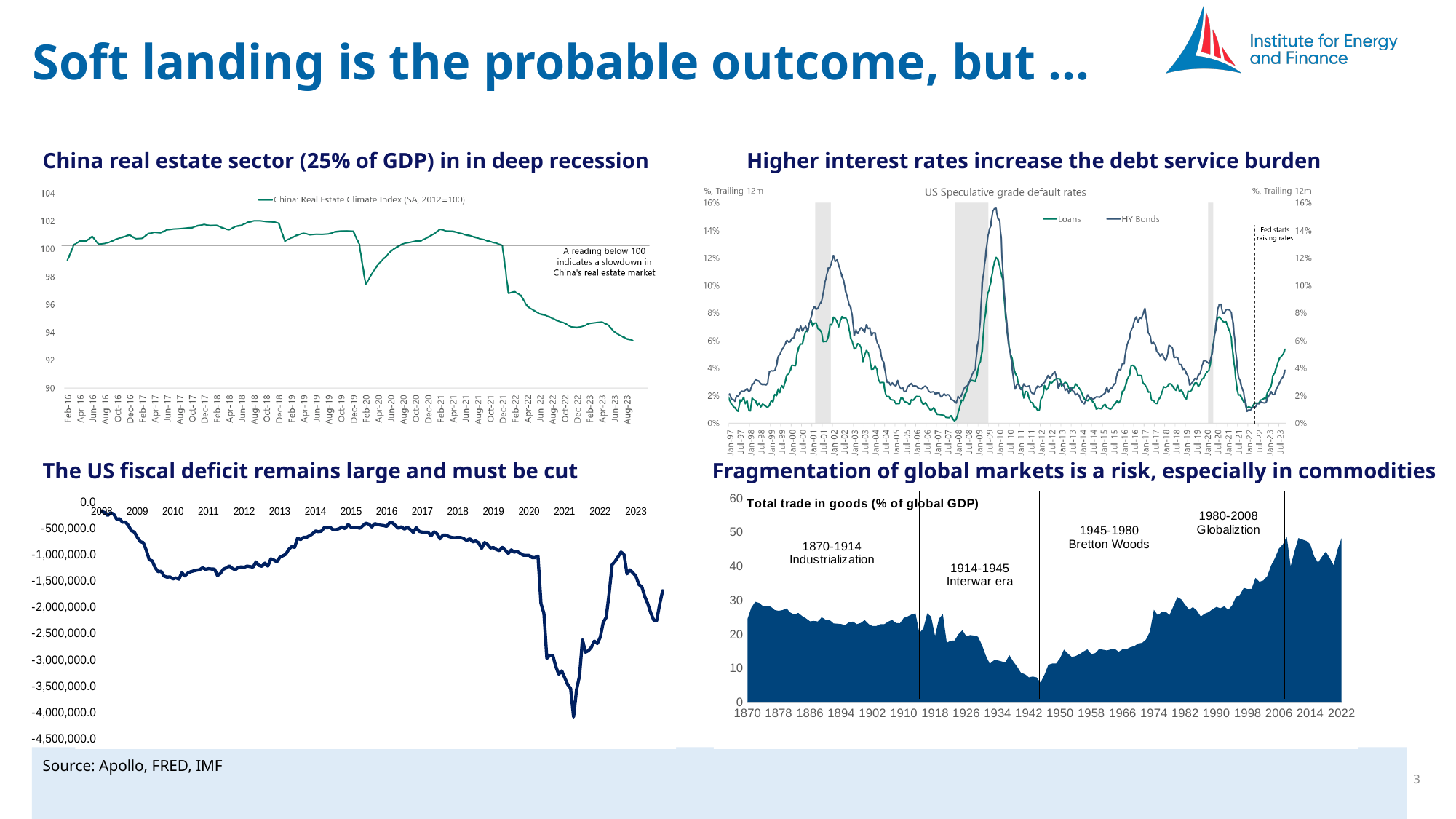
In the top-right chart (US Speculative grade default rates), which series reaches the higher peak around 2009, Loans or HY Bonds? HY Bonds In the bottom-right chart (Total trade in goods), is the value around 1942 greater or less than 10? less In the top-right chart (US Speculative grade default rates), how many series does the legend list? 2 In the top-left chart, what series does the legend name? China: Real Estate Climate Index (SA, 2012=100) In the bottom-right chart (Total trade in goods), is the value for 1870 greater or less than 20? greater What kind of chart is the top-left chart on China's real estate climate index? line chart In the top-right chart (US Speculative grade default rates), is the peak value of HY Bonds around 2009 greater or less than 14%? greater What kind of chart is the bottom-right chart on total trade in goods? area chart In the bottom-left chart (US fiscal deficit), how many year labels are shown on the x axis? 16